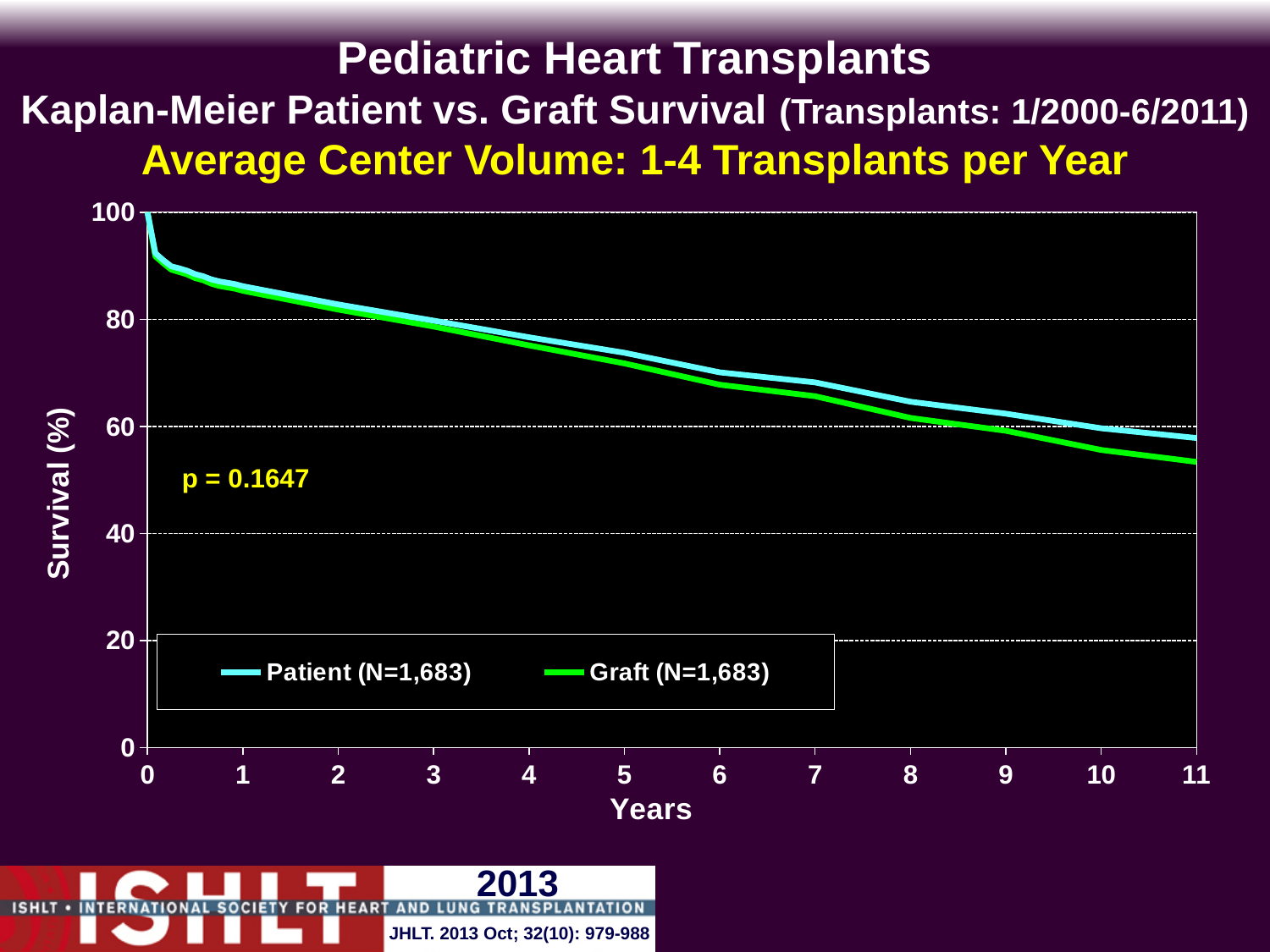
Is the Patient survival value at year 1 greater or less than 80? greater At year 10, which curve is higher, Patient or Graft? Patient Is the Graft survival value at year 4 greater or less than 80? less What kind of chart is shown on the slide? line chart Is the Patient survival value at year 5 greater or less than 60? greater How many series does the legend list? 2 What p-value is printed on the chart? p = 0.1647 Do the survival curves rise or fall as the years increase? fall What N is given for the Graft series in the legend? N=1,683 What is the survival value for both curves at year 0? 100